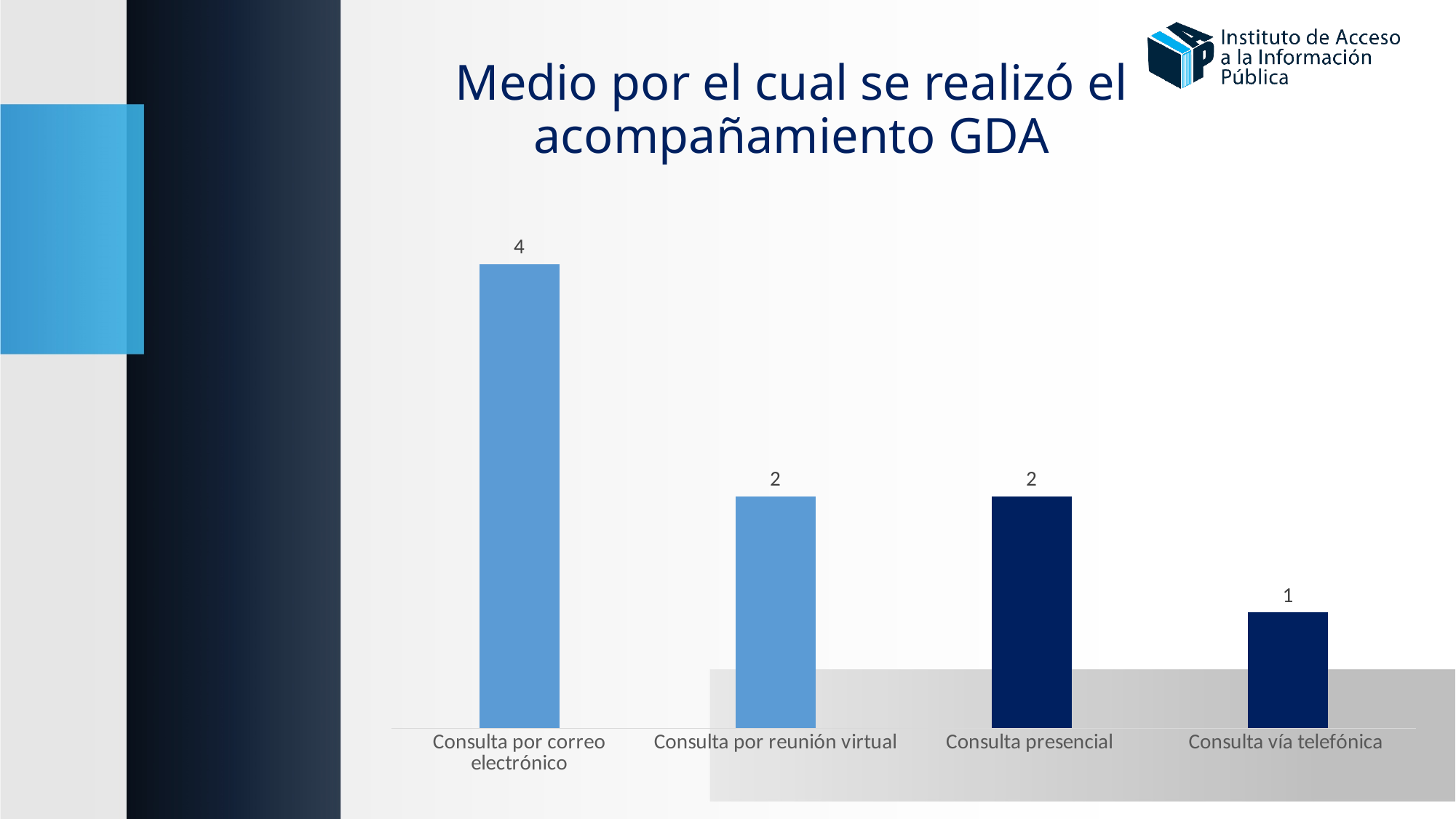
What is the value for Consulta presencial? 2 Which category has the lowest value? Consulta vía telefónica Which category has the highest value? Consulta por correo electrónico What is the value for Consulta por correo electrónico? 4 What is the difference between the values for Consulta por correo electrónico and Consulta presencial? 2 What kind of chart is shown on the slide? Bar chart How many categories are shown in the chart? 4 Which is larger, the value for Consulta por reunión virtual or the value for Consulta vía telefónica? Consulta por reunión virtual What is the difference between the values for Consulta por correo electrónico and Consulta vía telefónica? 3 What is the title of the slide? Medio por el cual se realizó el acompañamiento GDA What is the value for Consulta por reunión virtual? 2 What is the value for Consulta vía telefónica? 1